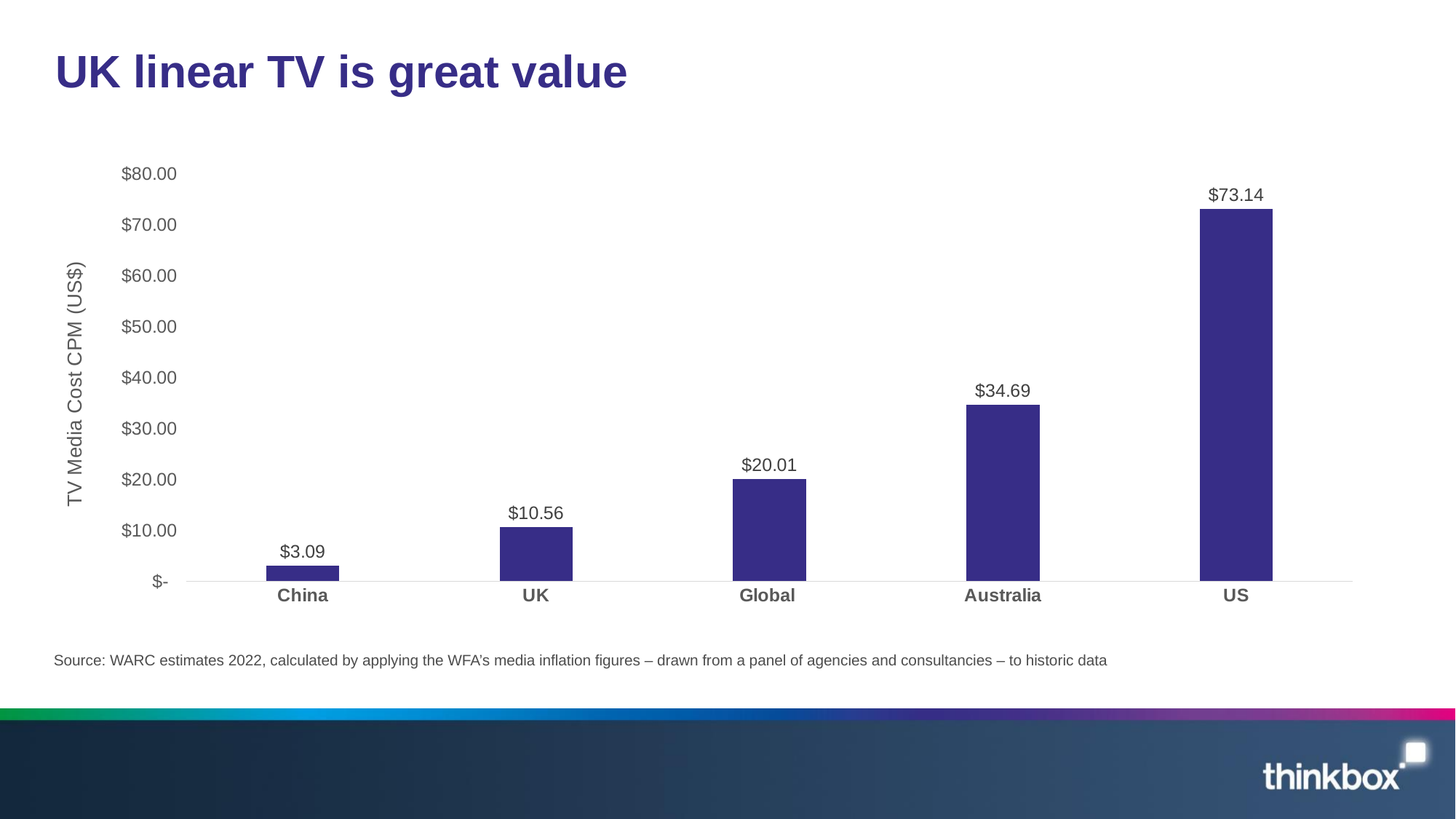
Which market has the highest TV media cost CPM? US What is the TV media cost CPM for Australia? $34.69 What is the label on the vertical axis of the chart? TV Media Cost CPM (US$) What is the TV media cost CPM for the UK? $10.56 What is the Global TV media cost CPM? $20.01 What is the difference between the US and UK TV media cost CPM? $62.58 Is the value for Australia greater or less than $30.00? greater What kind of chart is shown on the slide? Bar chart Which has a higher TV media cost CPM, Australia or Global? Australia How many markets are shown on the chart? 5 What is the TV media cost CPM for the US? $73.14 Which market has the lowest TV media cost CPM? China